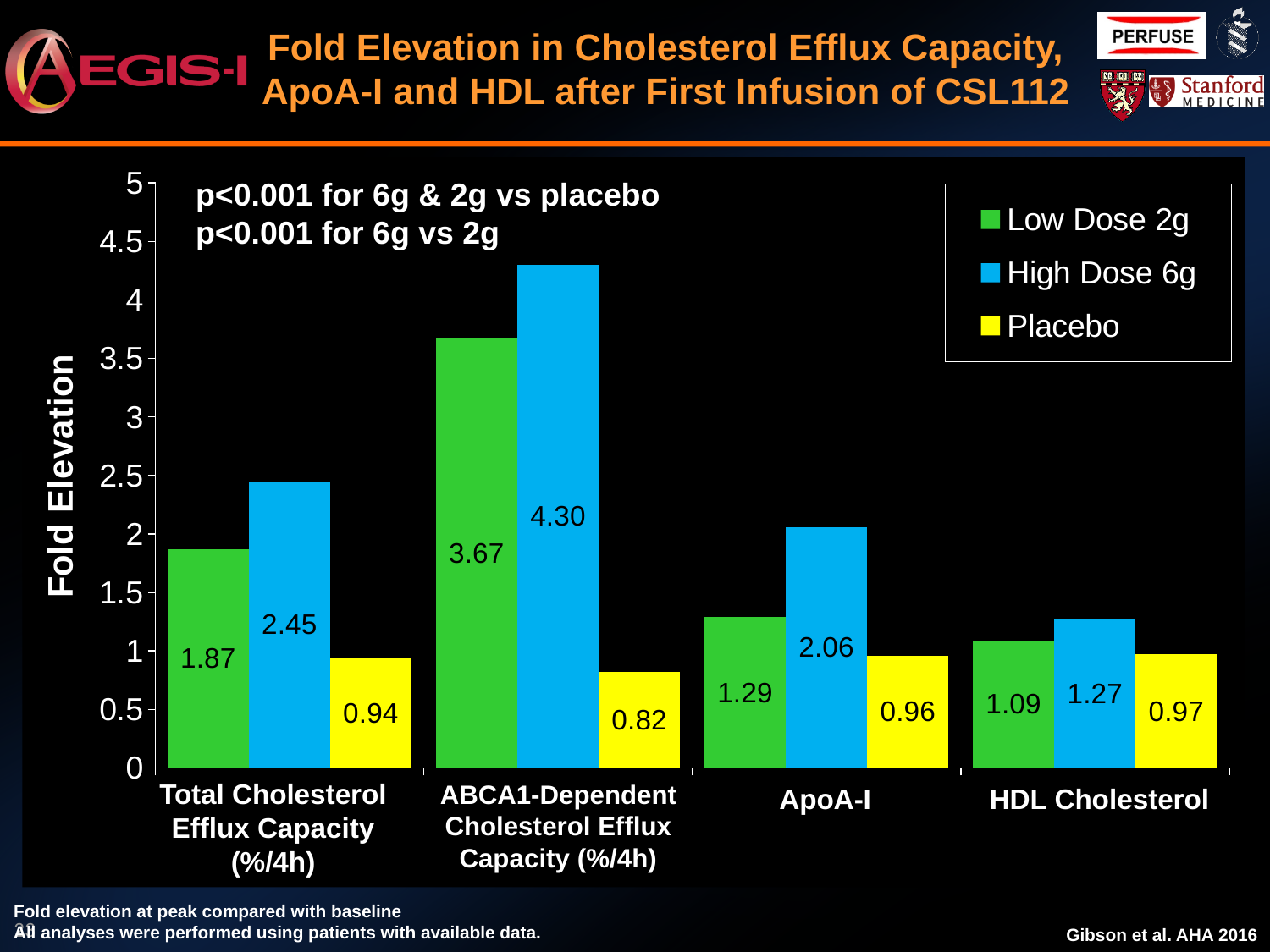
What is the fold elevation for Placebo in ApoA-I? 0.96 How many categories are shown on the x axis? 4 What kind of chart is shown on the slide? Bar chart What is the difference between the High Dose 6g and Low Dose 2g fold elevation in ABCA1-Dependent Cholesterol Efflux Capacity (%/4h)? 0.63 How many series does the legend list? 3 What is the fold elevation for High Dose 6g in ABCA1-Dependent Cholesterol Efflux Capacity (%/4h)? 4.30 Is the High Dose 6g value for Total Cholesterol Efflux Capacity (%/4h) greater or less than 2? greater Which category has the highest fold elevation for High Dose 6g? ABCA1-Dependent Cholesterol Efflux Capacity (%/4h) What is the fold elevation for Low Dose 2g in Total Cholesterol Efflux Capacity (%/4h)? 1.87 Which is larger in ApoA-I: the Low Dose 2g value or the High Dose 6g value? High Dose 6g Which category has the lowest fold elevation for Placebo? ABCA1-Dependent Cholesterol Efflux Capacity (%/4h) What is the fold elevation for High Dose 6g in HDL Cholesterol? 1.27